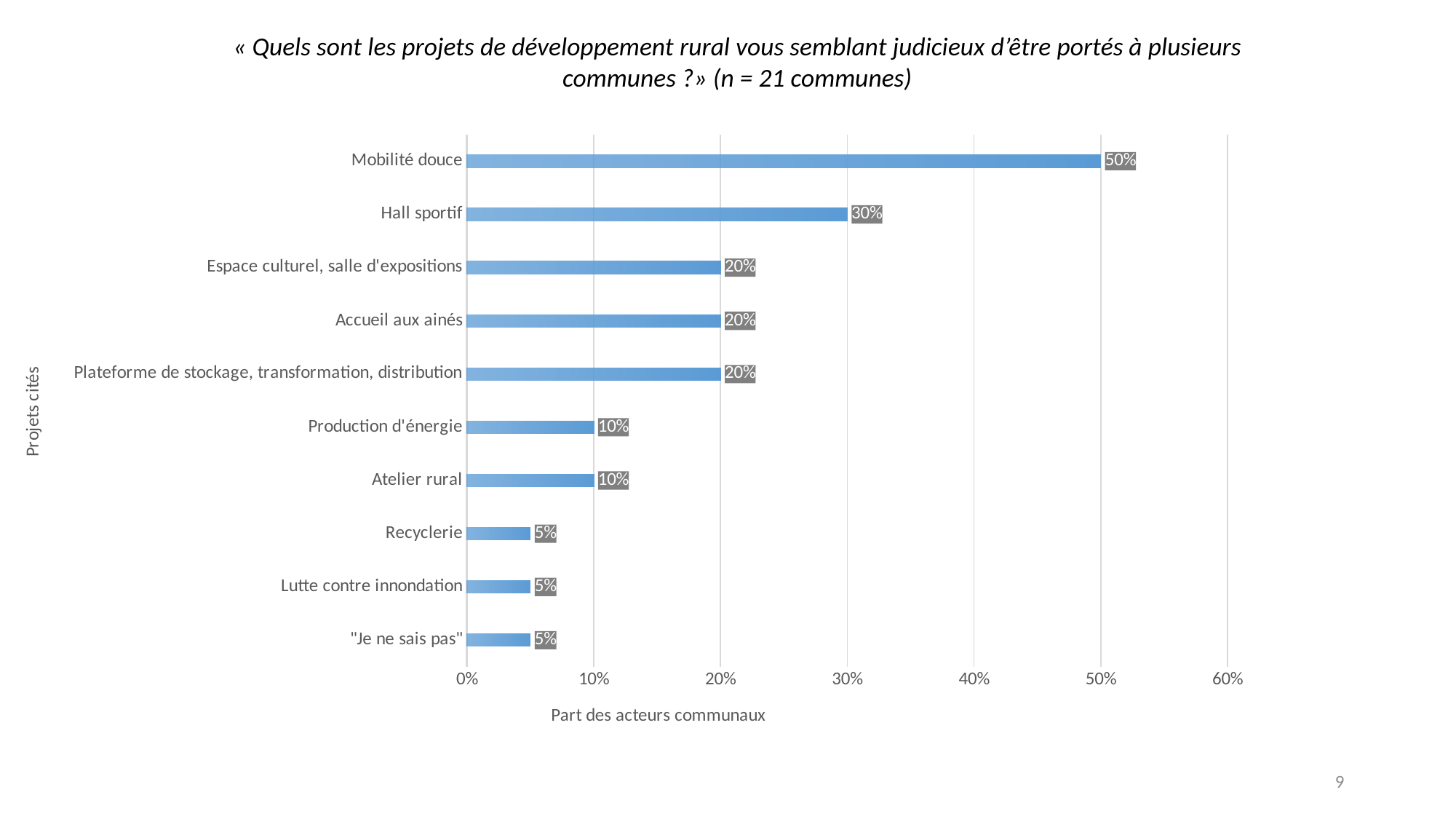
Which project has the highest value? Mobilité douce What is the value for Mobilité douce? 50% How many projects are shown on the chart? 10 Is the value for Mobilité douce greater or less than 40%? greater What is the value for Hall sportif? 30% What is the value for Recyclerie? 5% What is the difference between the values for Mobilité douce and Hall sportif? 20% What kind of chart is shown on the slide? bar chart Which is larger, the value for Hall sportif or the value for Espace culturel, salle d'expositions? Hall sportif What is the difference between the values for Accueil aux ainés and Atelier rural? 10% What is the value for Production d'énergie? 10% What is the label of the horizontal axis? Part des acteurs communaux